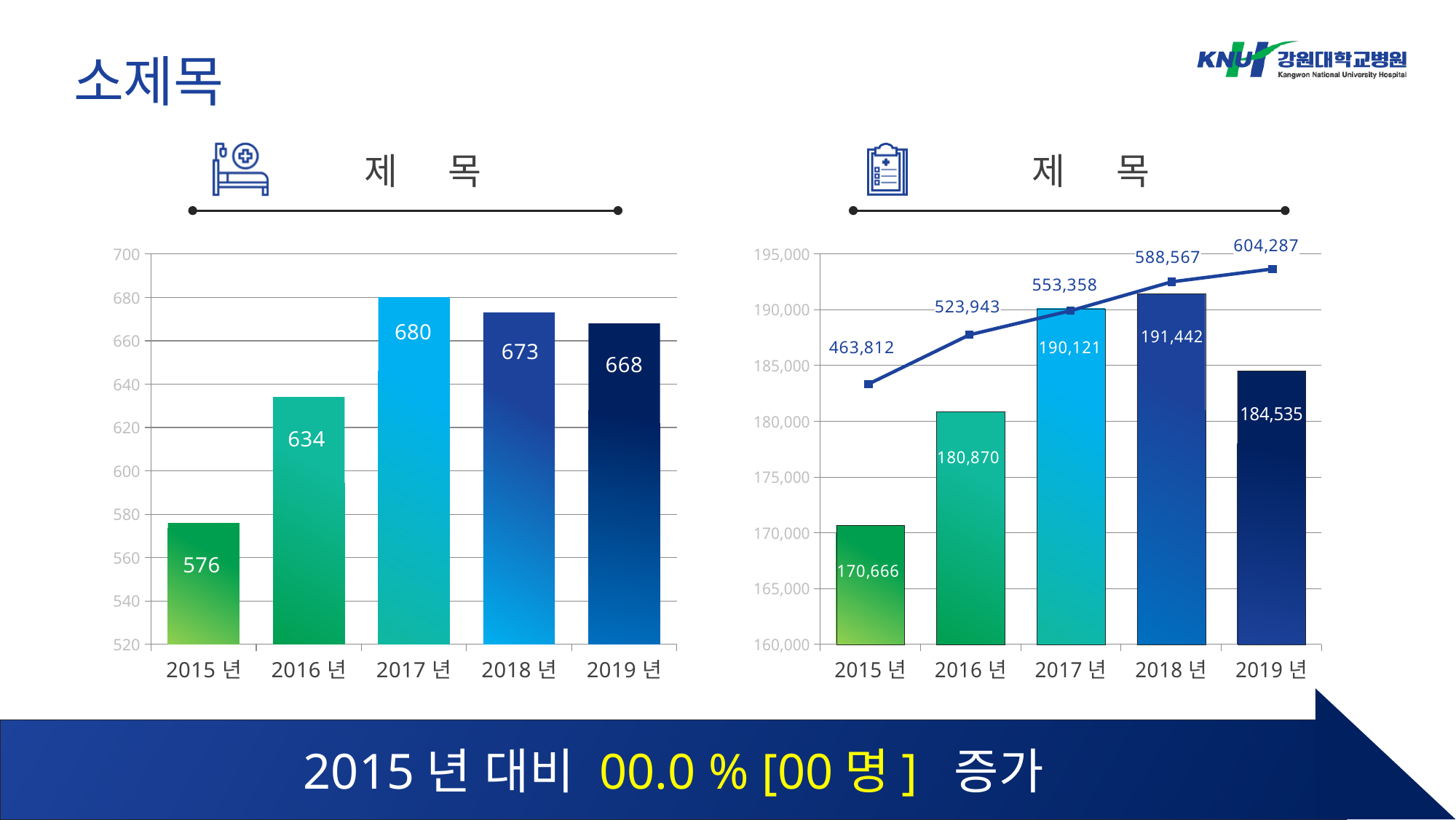
On the right chart, what is the line value for 2019 년? 604,287 On the left chart, which year has the highest value? 2017 년 On the right chart, which year has the lowest bar value? 2015 년 On the left chart, which year has the lowest value? 2015 년 On the left chart, what is the difference between the values for 2017 년 and 2015 년? 104 On the left chart, what is the value for 2017 년? 680 On the right chart, what is the difference between the line values for 2016 년 and 2015 년? 60,131 On the right chart, what is the bar value for 2018 년? 191,442 On the left chart, how many years are shown on the x axis? 5 On the right chart, does the line rise or fall from 2015 년 to 2019 년? rises On the right chart, is the bar value for 2016 년 larger or smaller than the bar value for 2019 년? smaller What kind of chart is the left chart? bar chart